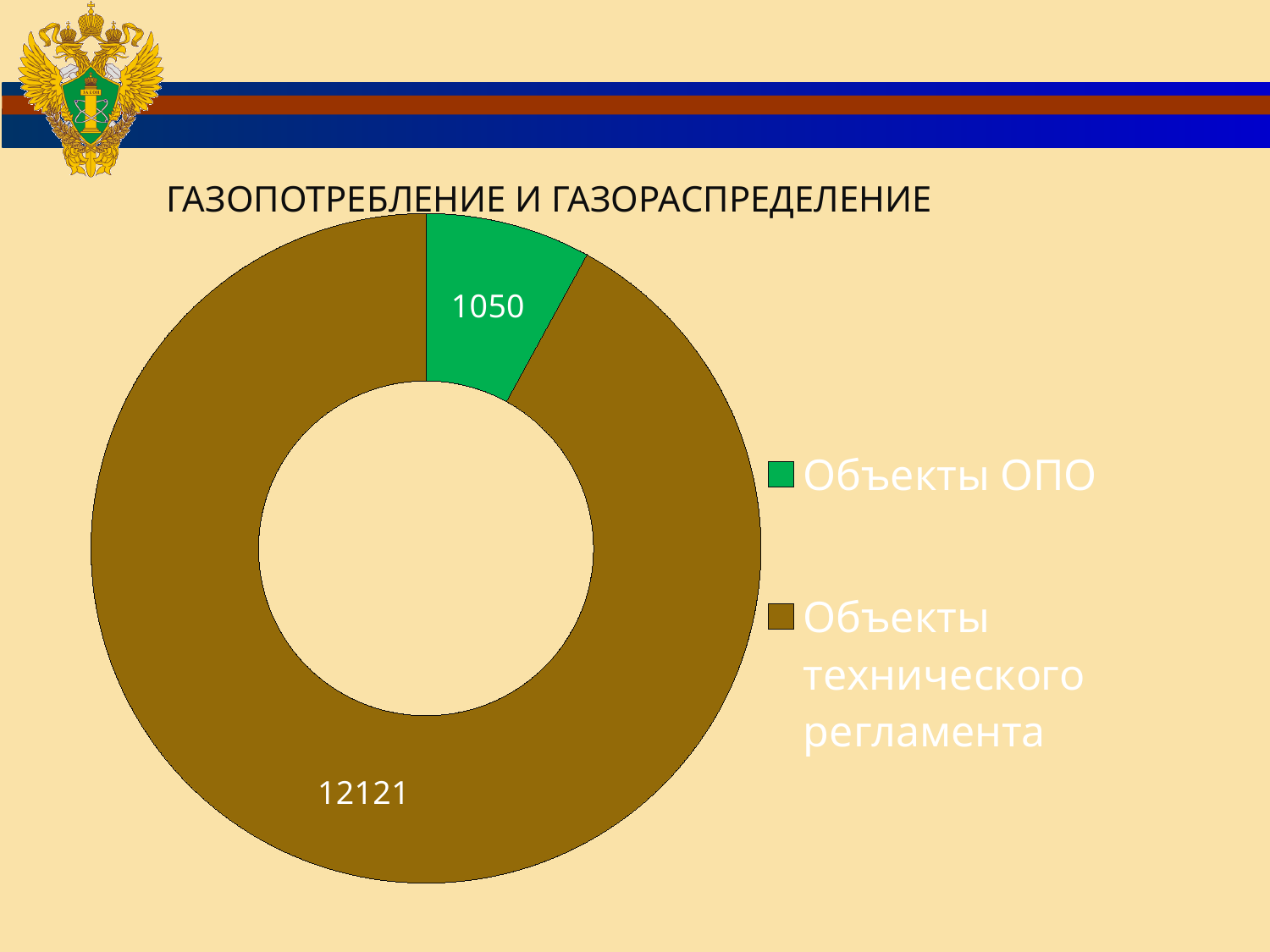
How many categories does the chart show? 2 What kind of chart is shown on the slide? Doughnut (pie) chart How many entries does the legend list? 2 What is the difference between the values for Объекты технического регламента and Объекты ОПО? 11071 What is the total of the two values shown in the chart? 13171 What is the value for Объекты технического регламента? 12121 Which category has the largest value? Объекты технического регламента Which category has the smallest value? Объекты ОПО What is the title of the chart? ГАЗОПОТРЕБЛЕНИЕ И ГАЗОРАСПРЕДЕЛЕНИЕ What is the value for Объекты ОПО? 1050 Which is larger, the value for Объекты ОПО or the value for Объекты технического регламента? Объекты технического регламента